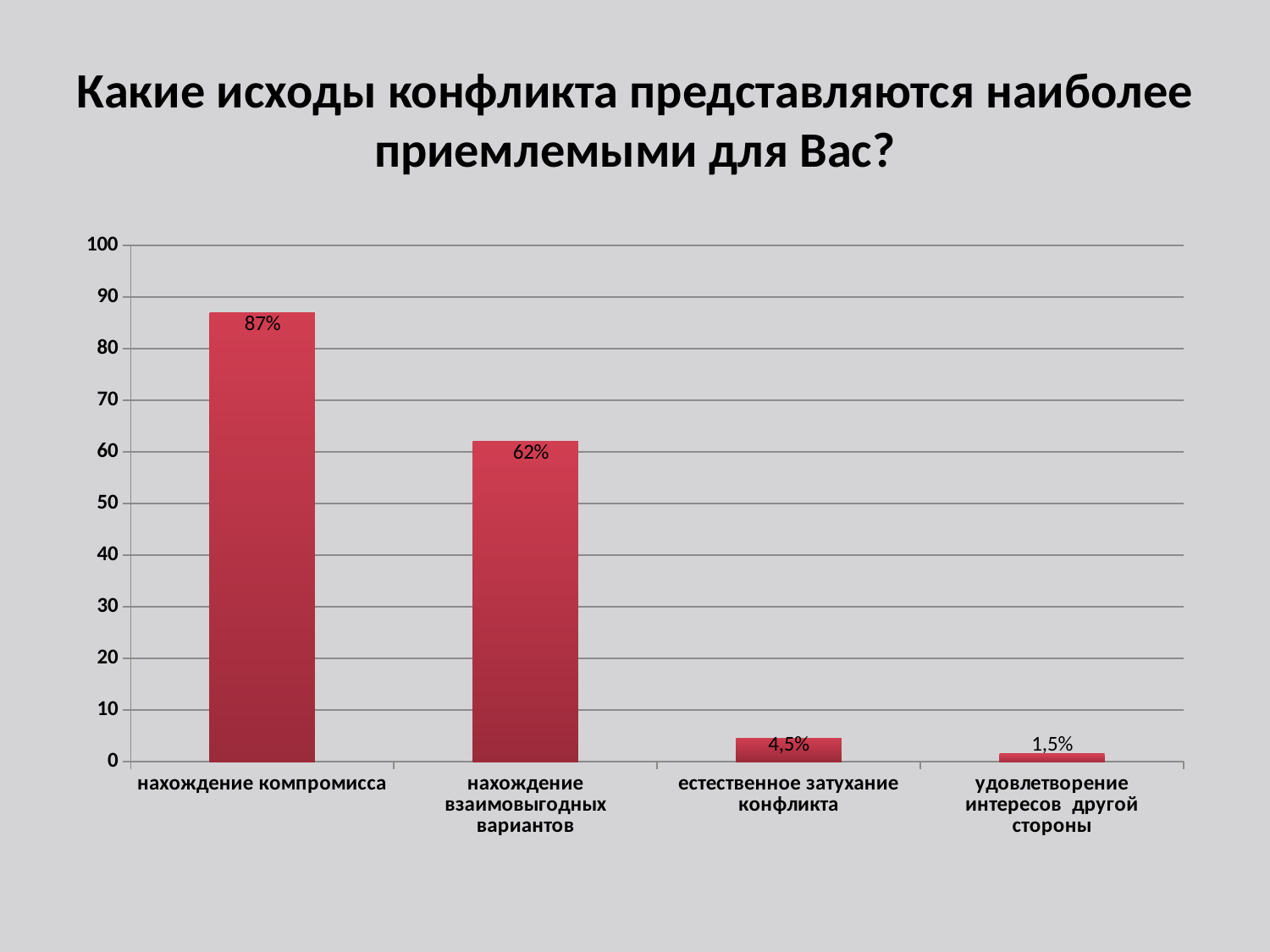
Which category has the highest value? нахождение компромисса Which is larger: the value for «естественное затухание конфликта» or for «удовлетворение интересов другой стороны»? естественное затухание конфликта What kind of chart is shown on the slide? bar chart Which category has the lowest value? удовлетворение интересов другой стороны How many categories are shown on the chart? 4 What is the value for «нахождение взаимовыгодных вариантов»? 62% What is the value for «удовлетворение интересов другой стороны»? 1,5% What is the value for «естественное затухание конфликта»? 4,5% What is the title of the slide? Какие исходы конфликта представляются наиболее приемлемыми для Вас? Is the value for «нахождение взаимовыгодных вариантов» greater or less than 50? greater What is the value for «нахождение компромисса»? 87% What is the difference between the values for «нахождение компромисса» and «нахождение взаимовыгодных вариантов»? 25%